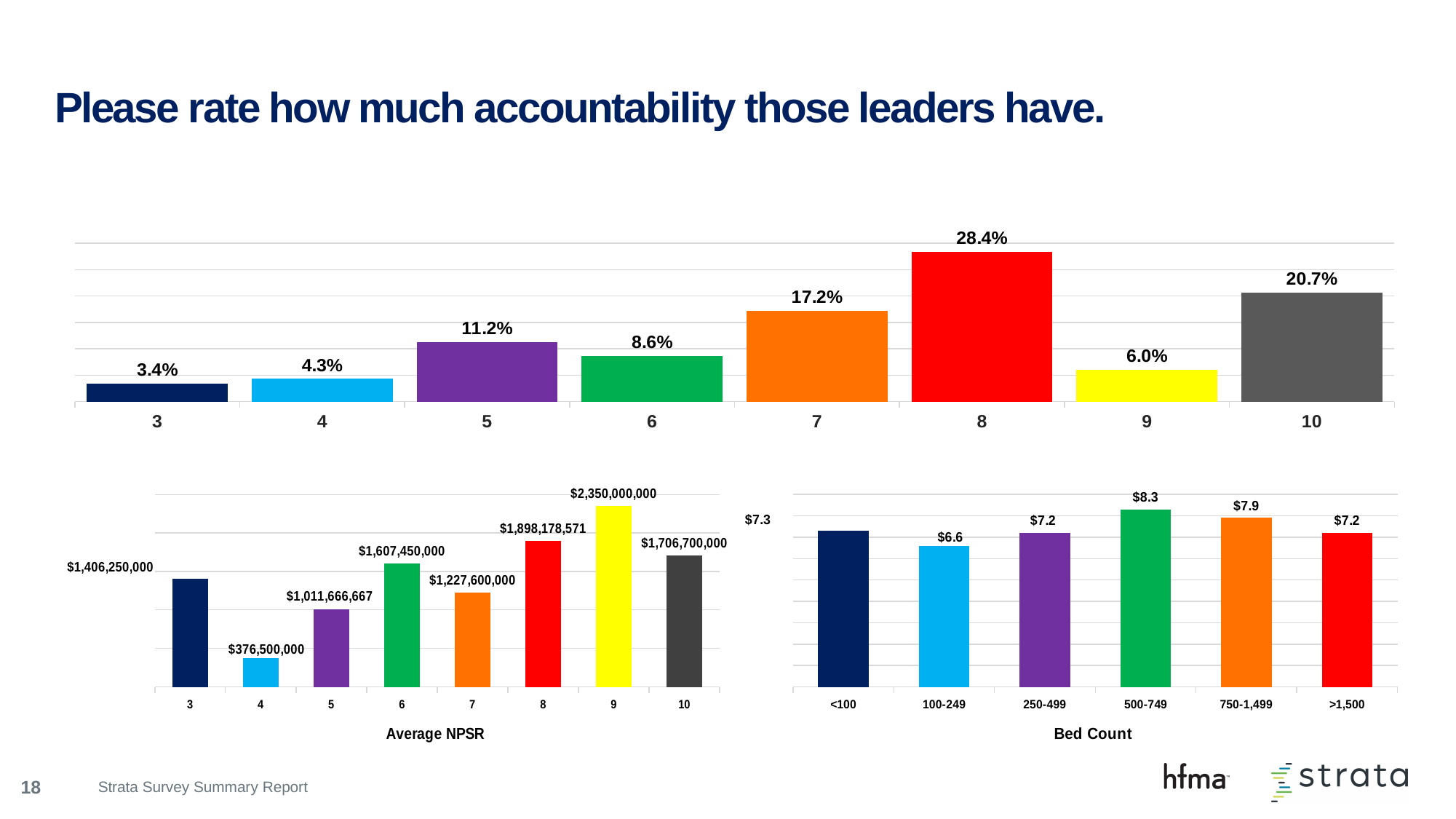
In the Bed Count chart, what is the value for the 500-749 category? $8.3 In the top chart, which rating has the lowest percentage? 3 In the top chart, what is the difference between the percentages for ratings 8 and 10? 7.7% In the Bed Count chart, which bed count category has the lowest value? 100-249 In the Average NPSR chart, which rating has the lowest average NPSR? 4 In the top chart, which is larger: the percentage for rating 5 or rating 6? Rating 5 In the Average NPSR chart, what is the value for rating 5? $1,011,666,667 In the top chart, which rating has the highest percentage? 8 In the top chart, what percentage of respondents gave a rating of 8? 28.4% How many rating categories are shown in the top chart? 8 In the Average NPSR chart, what is the value for rating 9? $2,350,000,000 What type of chart is the Bed Count chart? Bar chart